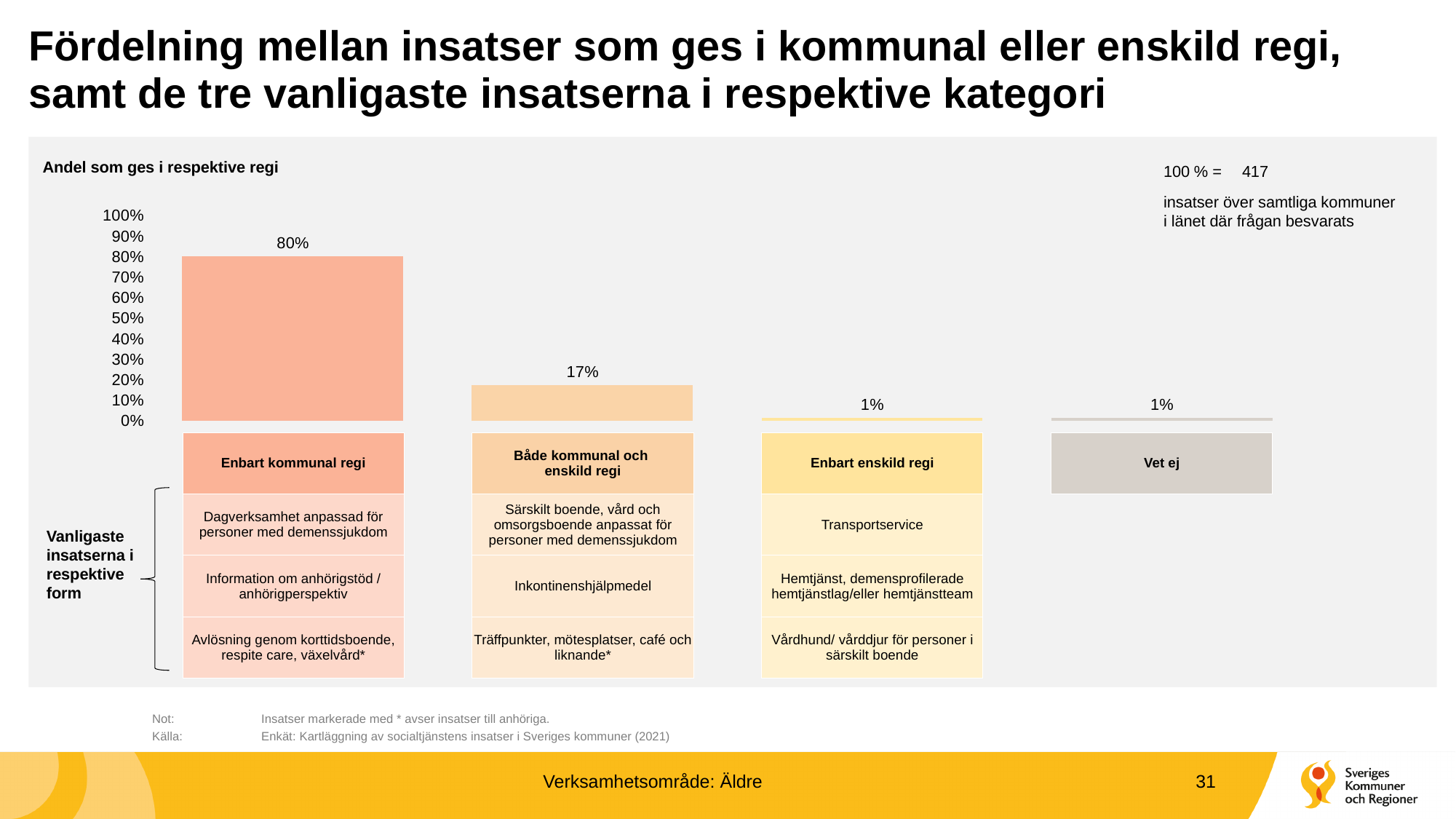
What share is shown for the 'Vet ej' category? 1% What kind of chart is shown on the slide? Bar chart How many categories are shown in the bar chart? 4 What is the total number of interventions that 100% corresponds to? 417 Which category has the highest share? Enbart kommunal regi What is the difference in percentage points between 'Enbart kommunal regi' and 'Både kommunal och enskild regi'? 63 percentage points Which is larger, the share for 'Både kommunal och enskild regi' or the share for 'Enbart enskild regi'? Både kommunal och enskild regi Is the value for 'Enbart kommunal regi' greater or less than 50%? greater What is the title of the chart area above the bars? Andel som ges i respektive regi What share of interventions is given under 'Både kommunal och enskild regi'? 17% What share of interventions is given under 'Enbart enskild regi'? 1% What share of interventions is given under 'Enbart kommunal regi'? 80%